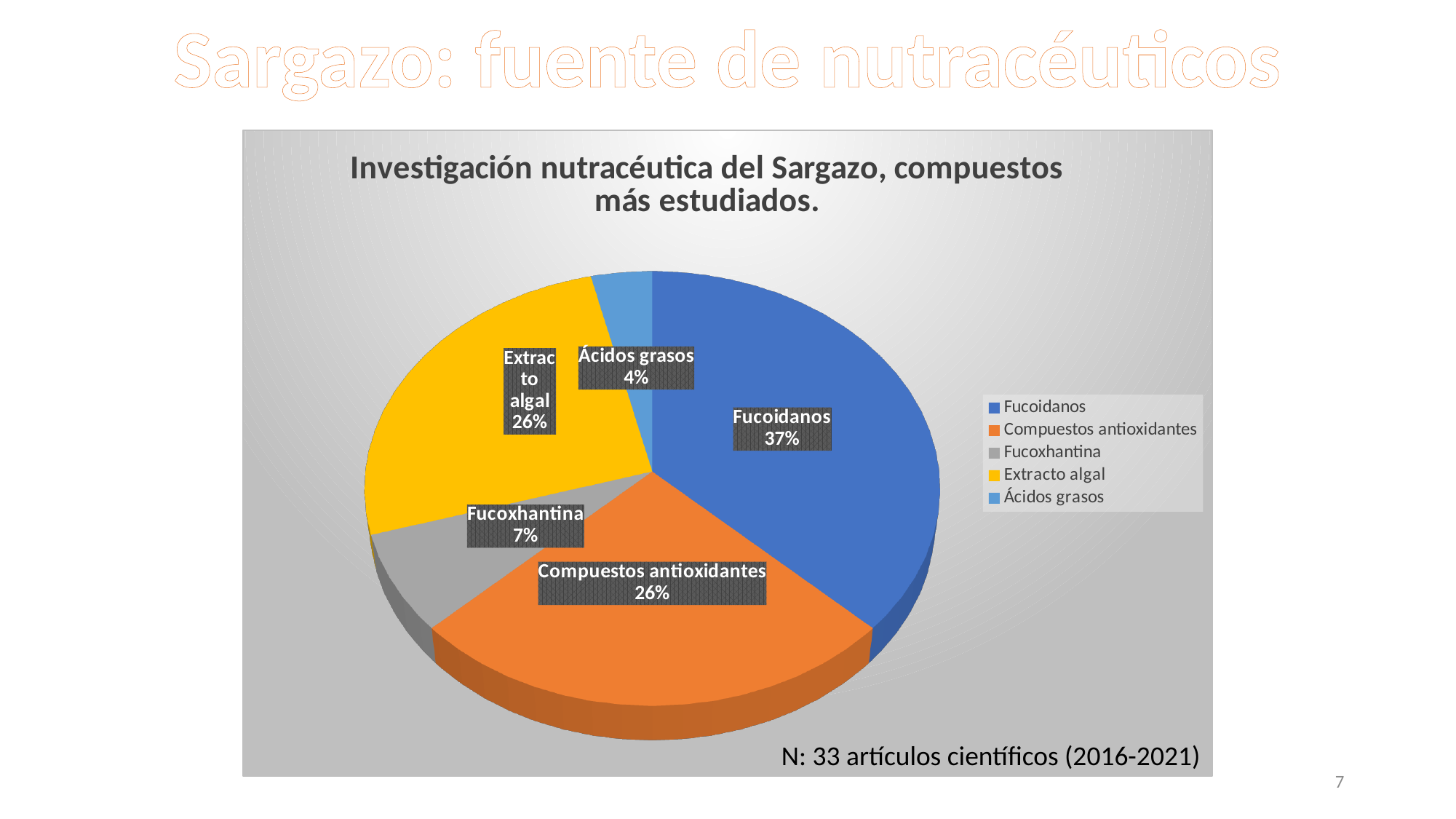
What kind of chart is shown on the slide? Pie chart What percentage is shown for Compuestos antioxidantes? 26% What is the difference in percentage points between Fucoidanos and Extracto algal? 11 What colour is the Extracto algal slice? Yellow Which category has the largest share of the pie? Fucoidanos What percentage of the pie does Fucoidanos represent? 37% What percentage is shown for Fucoxhantina? 7% How many categories does the pie chart have? 5 Which category has the smallest share of the pie? Ácidos grasos What is the title of the chart? Investigación nutracéutica del Sargazo, compuestos más estudiados. Which is larger, the share for Fucoxhantina or the share for Ácidos grasos? Fucoxhantina What percentage is shown for Ácidos grasos? 4%